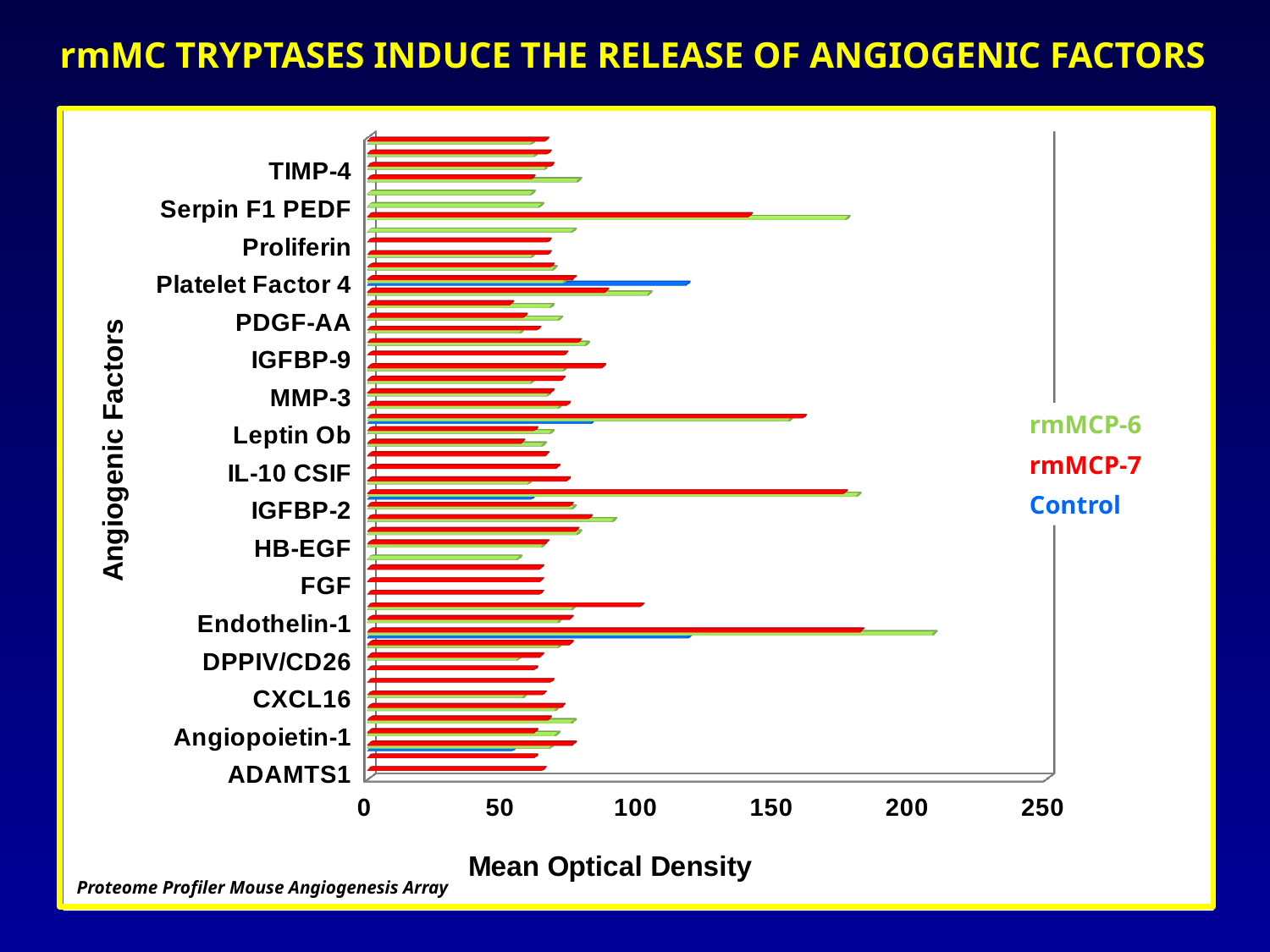
What kind of chart is shown on the slide? bar chart Is the longest bar on the chart greater or less than 200? greater What is the title of the x axis? Mean Optical Density Which series has a longer maximum bar, rmMCP-6 or Control? rmMCP-6 Which series has the longest bar on the chart? rmMCP-6 What are the three series named in the legend? rmMCP-6, rmMCP-7, Control How many series does the legend list? 3 Is any bar on the chart greater or less than 250? less